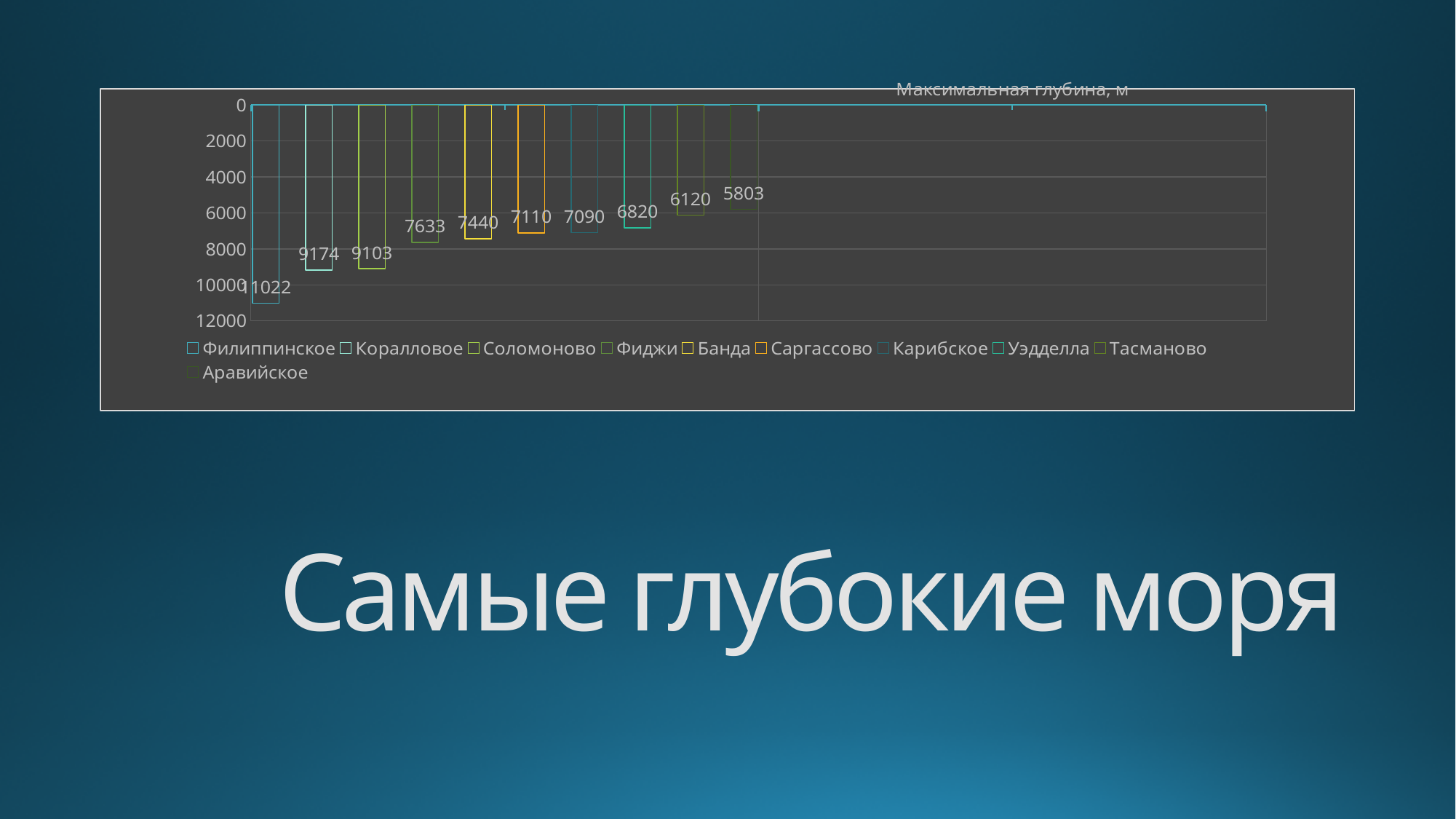
What is the difference between the values for Фиджи and Тасманово? 1513 What is the value for Банда? 7440 Which sea has the smallest maximum depth? Аравийское How many series does the legend list? 10 What is the value for Коралловое? 9174 What is the value for Соломоново? 9103 Which is larger, the value for Уэдделла or the value for Саргассово? Саргассово Which sea has the greatest maximum depth? Филиппинское Is the value for Карибское greater or less than 8000? less What is the value for Аравийское? 5803 What type of chart is shown on the slide? bar chart